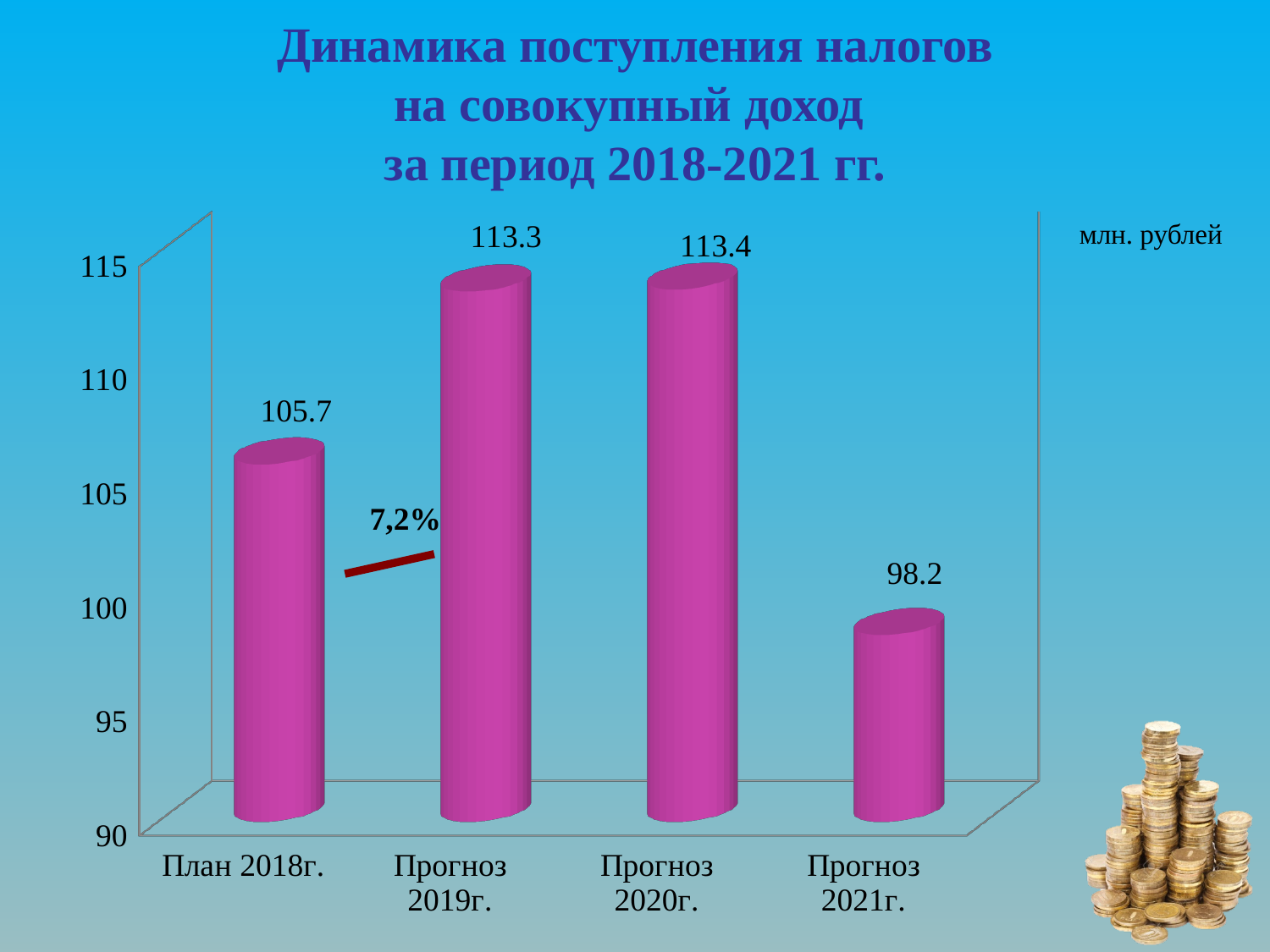
Which category has the lowest value? Прогноз 2021г. What unit is indicated for the values on the chart? млн. рублей What kind of chart is shown on the slide? bar chart What is the value for План 2018г.? 105.7 What is the difference between the values for Прогноз 2020г. and Прогноз 2021г.? 15.2 Is the value for Прогноз 2021г. greater or less than 100? less What is the value for Прогноз 2021г.? 98.2 What is the difference between the values for Прогноз 2019г. and План 2018г.? 7.6 How many categories are shown on the x axis? 4 What is the value for Прогноз 2020г.? 113.4 What is the value for Прогноз 2019г.? 113.3 Which is larger, the value for План 2018г. or the value for Прогноз 2021г.? План 2018г.